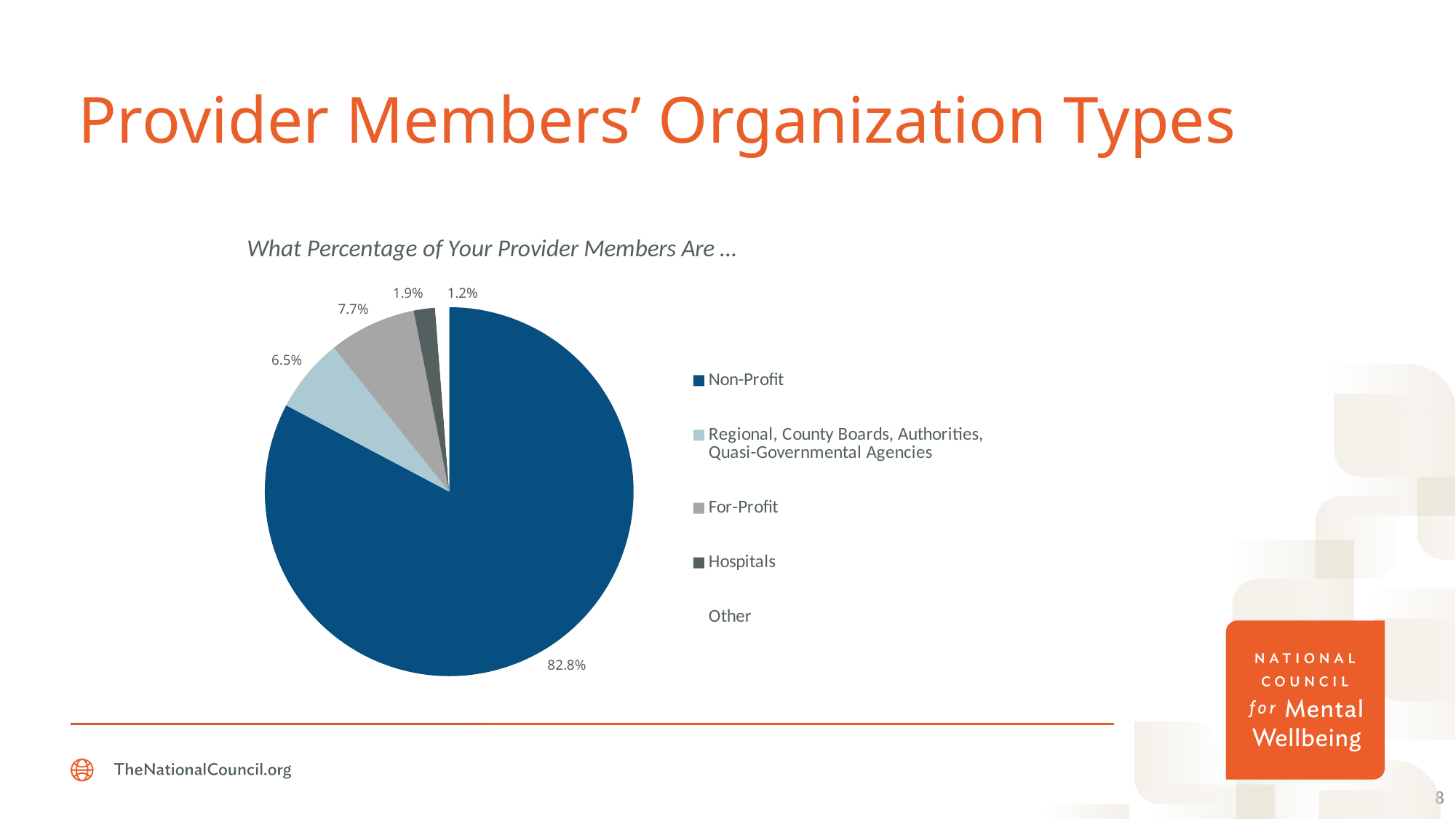
What percentage of provider members fall under Other? 1.2% How many categories does the legend list? 5 Which organization type has the smallest share of the pie? Other What is the difference in percentage points between the For-Profit share and the Hospitals share? 5.8 What percentage of provider members are Non-Profit? 82.8% What percentage of provider members are Hospitals? 1.9% What type of chart is shown on the slide? Pie chart Which is larger, the share for For-Profit or the share for Regional, County Boards, Authorities, Quasi-Governmental Agencies? For-Profit What percentage of provider members are For-Profit? 7.7% Which organization type has the largest share of the pie? Non-Profit What is the title of the pie chart? What Percentage of Your Provider Members Are ... What percentage of provider members are Regional, County Boards, Authorities, Quasi-Governmental Agencies? 6.5%